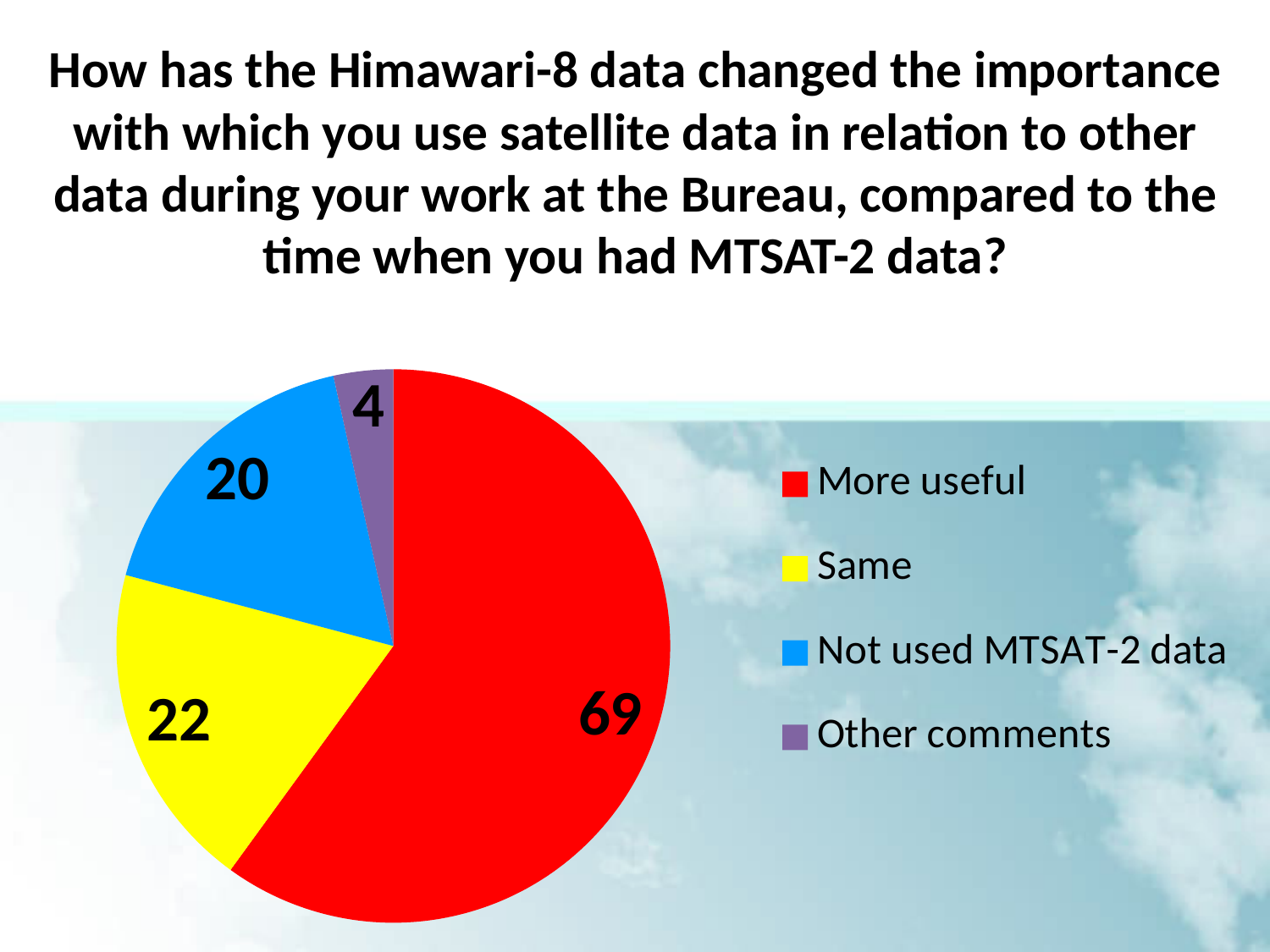
How many slices does the pie chart have? 4 Which is larger, the value for "Same" or the value for "Not used MTSAT-2 data"? Same What value is shown for the "Same" slice? 22 What is the total of all the slice values in the pie chart? 115 What kind of chart is shown on the slide? Pie chart What value is shown for the "Not used MTSAT-2 data" slice? 20 What value is shown for the "Other comments" slice? 4 What colour is the "Not used MTSAT-2 data" slice? Blue Which category has the smallest slice of the pie? Other comments What is the difference between the "More useful" value and the "Same" value? 47 Which category has the largest slice of the pie? More useful What value is shown for the "More useful" slice? 69